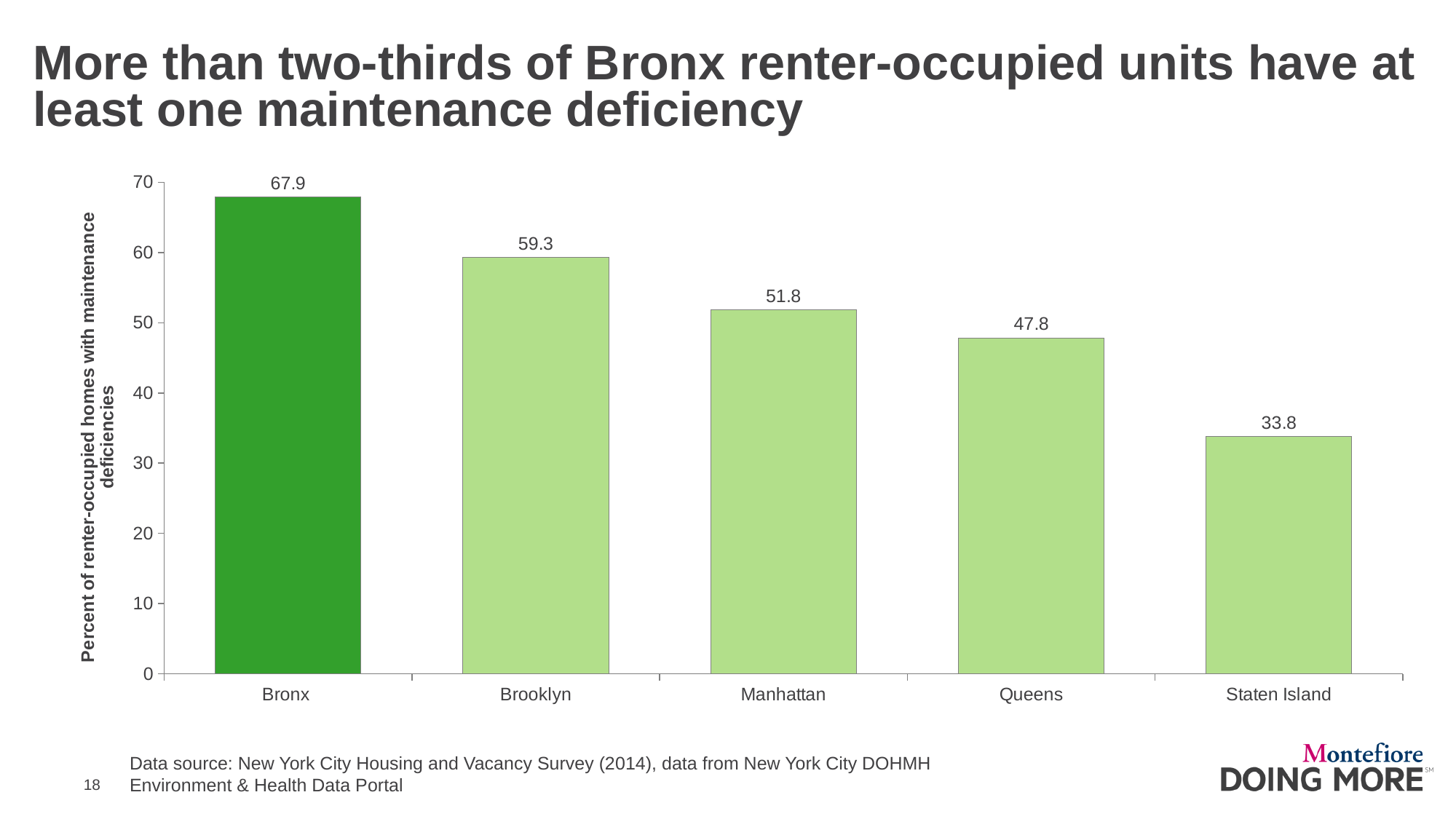
What is the value for Bronx? 67.9 Do the values rise or fall from Bronx to Staten Island along the x axis? fall Which borough has the lowest percent of renter-occupied homes with maintenance deficiencies? Staten Island What kind of chart is shown on the slide? bar chart What is the value for Manhattan? 51.8 What is the value for Staten Island? 33.8 Is the value for Queens greater or less than 50? less How many boroughs are shown on the chart? 5 Which has a larger value, Brooklyn or Queens? Brooklyn Which borough has the highest percent of renter-occupied homes with maintenance deficiencies? Bronx What is the difference between the values for Queens and Staten Island? 14 What is the difference between the values for Bronx and Brooklyn? 8.6